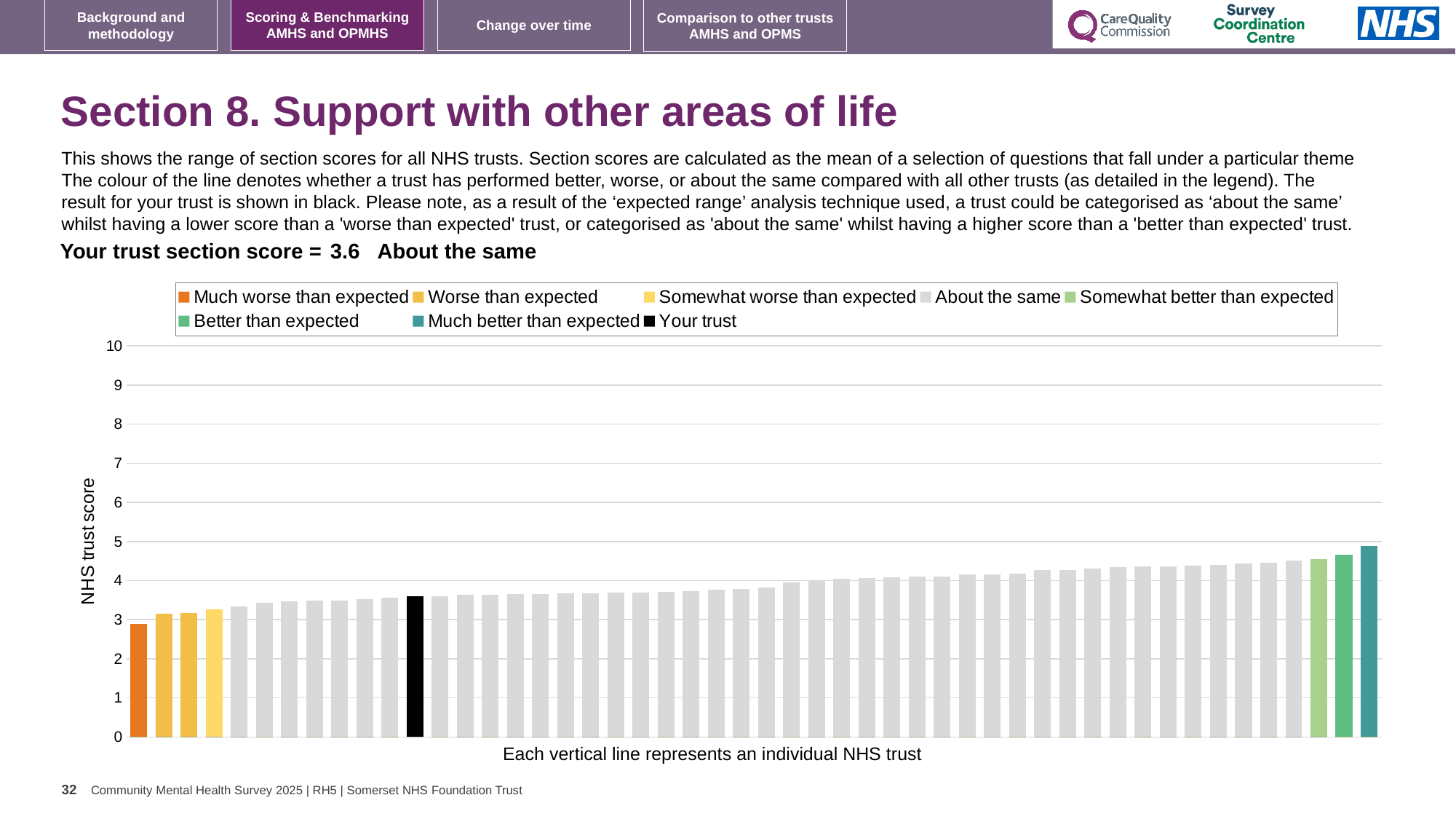
Is the value of the tallest bar greater or less than 4? greater How many bars are coloured orange ('Much worse than expected')? 1 Which category is your trust placed in for this section? About the same Is the black 'Your trust' bar higher or lower than the orange 'Much worse than expected' bar? higher What is the section score for your trust? 3.6 Is the value of the shortest bar greater or less than 2? greater Is the value of the black 'Your trust' bar greater or less than 3? greater Do the bar values rise or fall from left to right along the x axis? rise How many entries does the chart legend list? 8 What is the label on the y axis of the chart? NHS trust score What kind of chart is shown on the slide? bar chart